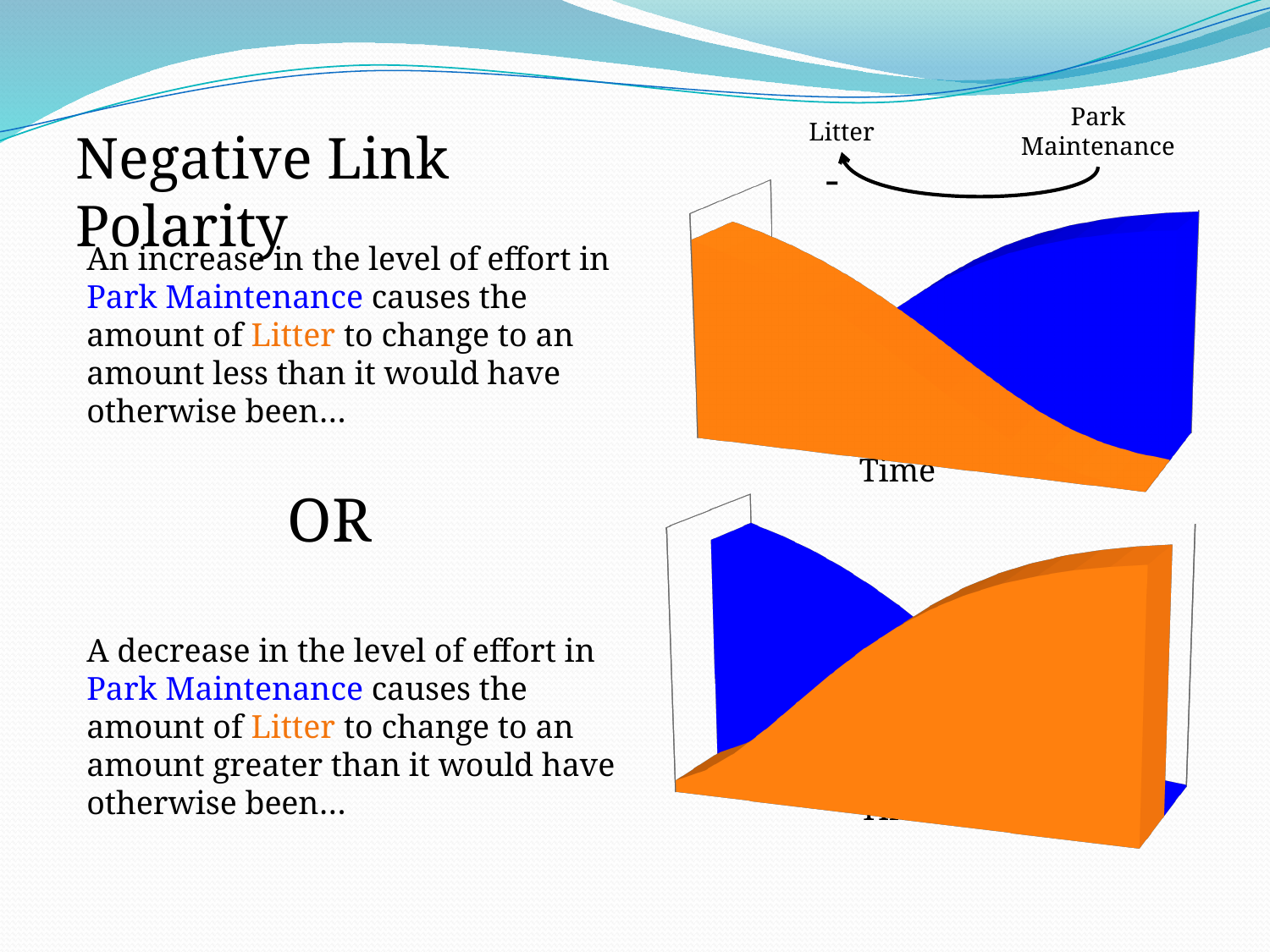
In the top chart, does the orange area rise or fall along the x axis? fall How many data series are plotted in the top chart? 2 In the bottom chart, does the blue area rise or fall along the x axis? fall In the top chart, at the right end of the x axis, which area is higher, the orange or the blue? blue In the top chart, does the blue area rise or fall along the x axis? rise What kind of chart is the top chart on the right of the slide? area chart What is the x-axis label of the top chart? Time How many data series are plotted in the bottom chart? 2 What kind of chart is the bottom chart on the right of the slide? area chart In the top chart, at the left end of the x axis, which area is higher, the orange or the blue? orange In the bottom chart, at the right end of the x axis, which area is higher, the orange or the blue? orange